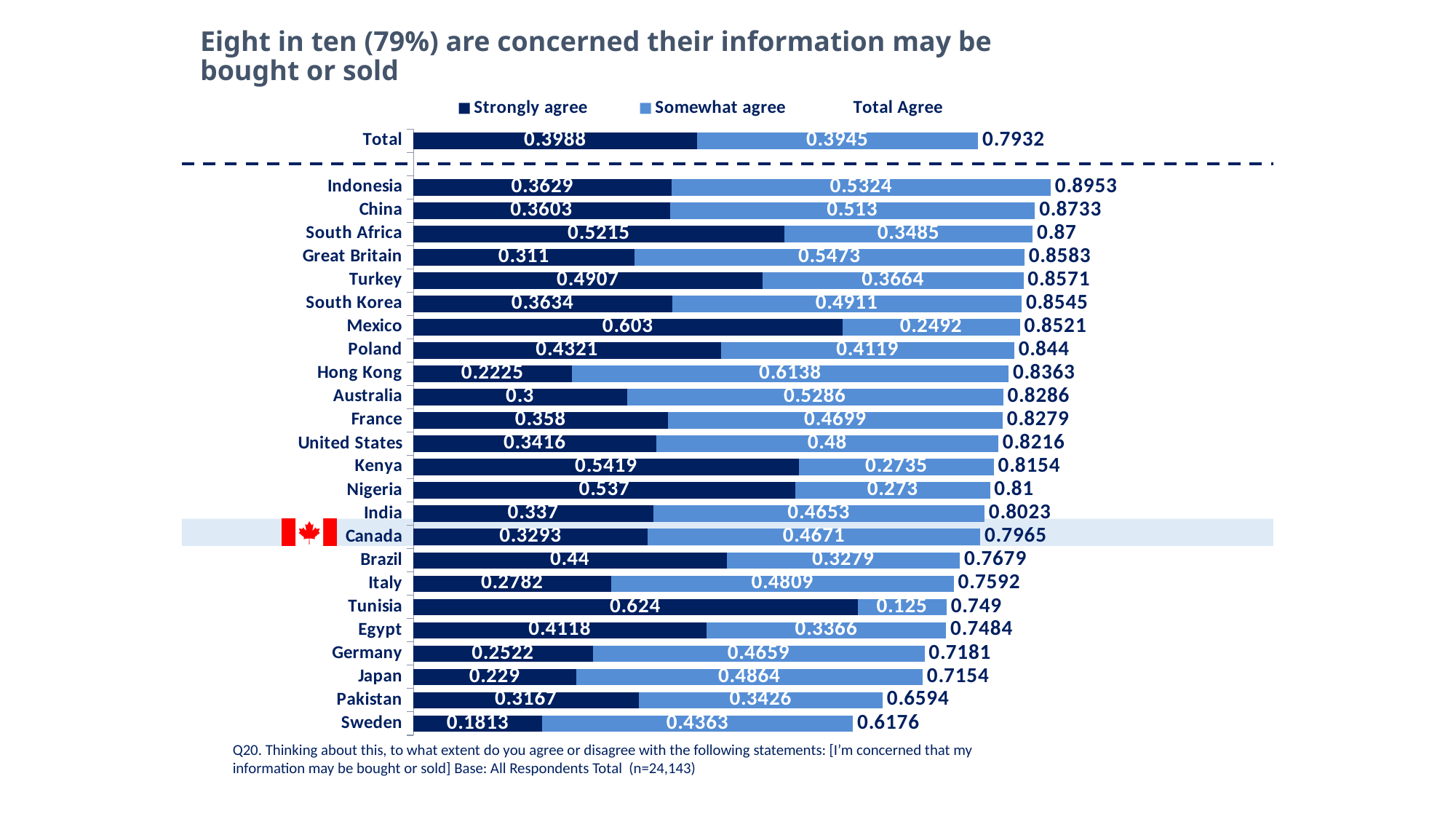
Which country has the lowest Total Agree value? Sweden What is the Somewhat agree value for Hong Kong? 0.6138 What is the Total Agree value for the Total row? 0.7932 How many entries does the legend list? 3 Which country has the highest Strongly agree value? Tunisia Which is larger for Mexico: the Strongly agree value or the Somewhat agree value? Strongly agree What is the difference between the Total Agree values for Indonesia and Sweden? 0.2777 What is the Strongly agree value for Canada? 0.3293 What kind of chart is shown on the slide? Stacked bar chart What is the Total Agree value for Indonesia? 0.8953 Which country has the lowest Somewhat agree value? Tunisia How many countries are listed below the dashed line in the chart? 24